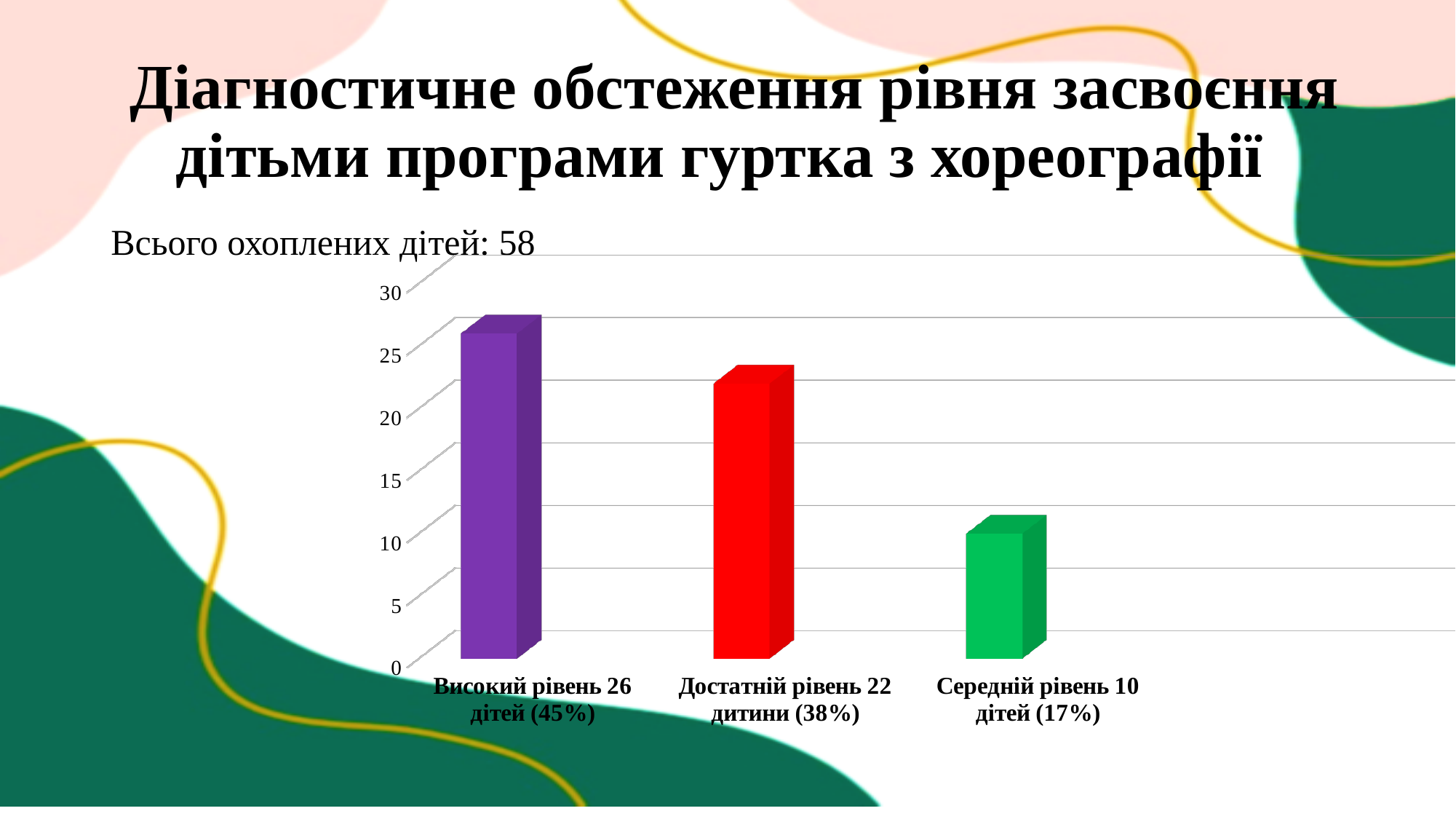
Do the bar values rise or fall from left to right across the chart? fall How many children are at the sufficient level (Достатній рівень)? 22 Which level has the highest number of children? Високий рівень Which level has the lowest number of children? Середній рівень What is the difference between the number of children at the high level and at the medium level? 16 What percentage of children are at the medium level (Середній рівень)? 17% Which is larger: the number of children at the high level or at the sufficient level? Високий рівень How many children are at the medium level (Середній рівень)? 10 How many children are at the high level (Високий рівень) according to the chart? 26 What kind of chart is shown on the slide? bar chart How many categories (bars) does the chart show? 3 What colour is the bar for the sufficient level (Достатній рівень)? red